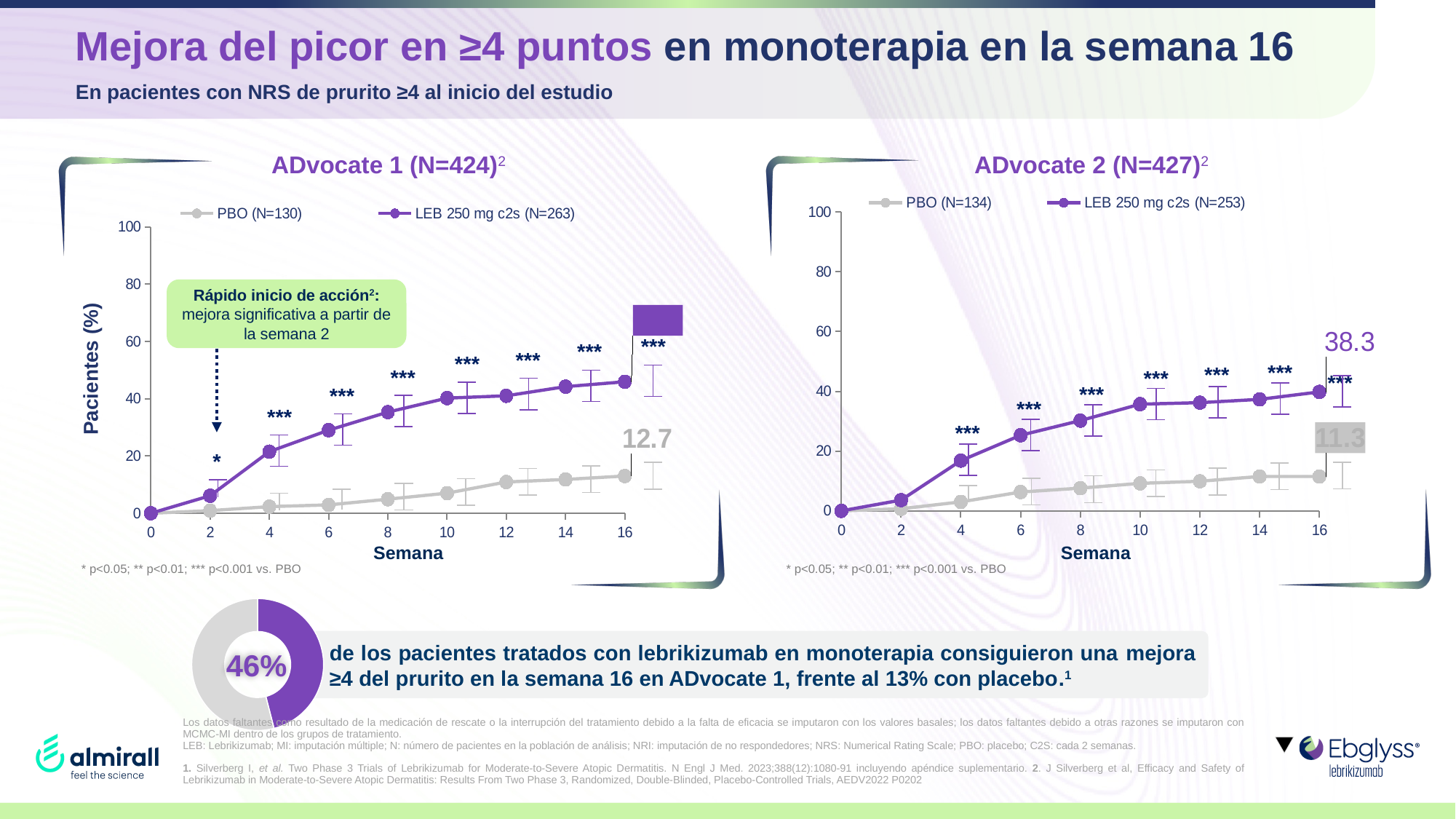
In the ADvocate 2 (N=427) chart, does the LEB 250 mg c2s series rise or fall from week 0 to week 16? Rise In the ADvocate 2 (N=427) chart, what is the difference between the LEB 250 mg c2s and PBO values at week 16? 27.0 In the ADvocate 1 (N=424) chart, what is the value for PBO at week 16? 12.7 In the ADvocate 2 (N=427) chart, what is the value for LEB 250 mg c2s at week 16? 38.3 How many week ticks are shown on the x axis of the ADvocate 1 (N=424) chart? 9 In the ADvocate 1 (N=424) chart, which series has the higher value at week 16, LEB 250 mg c2s or PBO? LEB 250 mg c2s What percentage does the donut chart at the bottom of the slide show? 46% What kind of chart is the ADvocate 1 (N=424) chart? Line chart In the ADvocate 2 (N=427) chart, what is the value for PBO at week 16? 11.3 In the ADvocate 2 (N=427) chart, is the value for LEB 250 mg c2s at week 8 greater or less than 20? greater In the ADvocate 1 (N=424) chart, is the value for LEB 250 mg c2s at week 16 greater or less than 40? greater How many series does the legend of the ADvocate 2 (N=427) chart list? 2